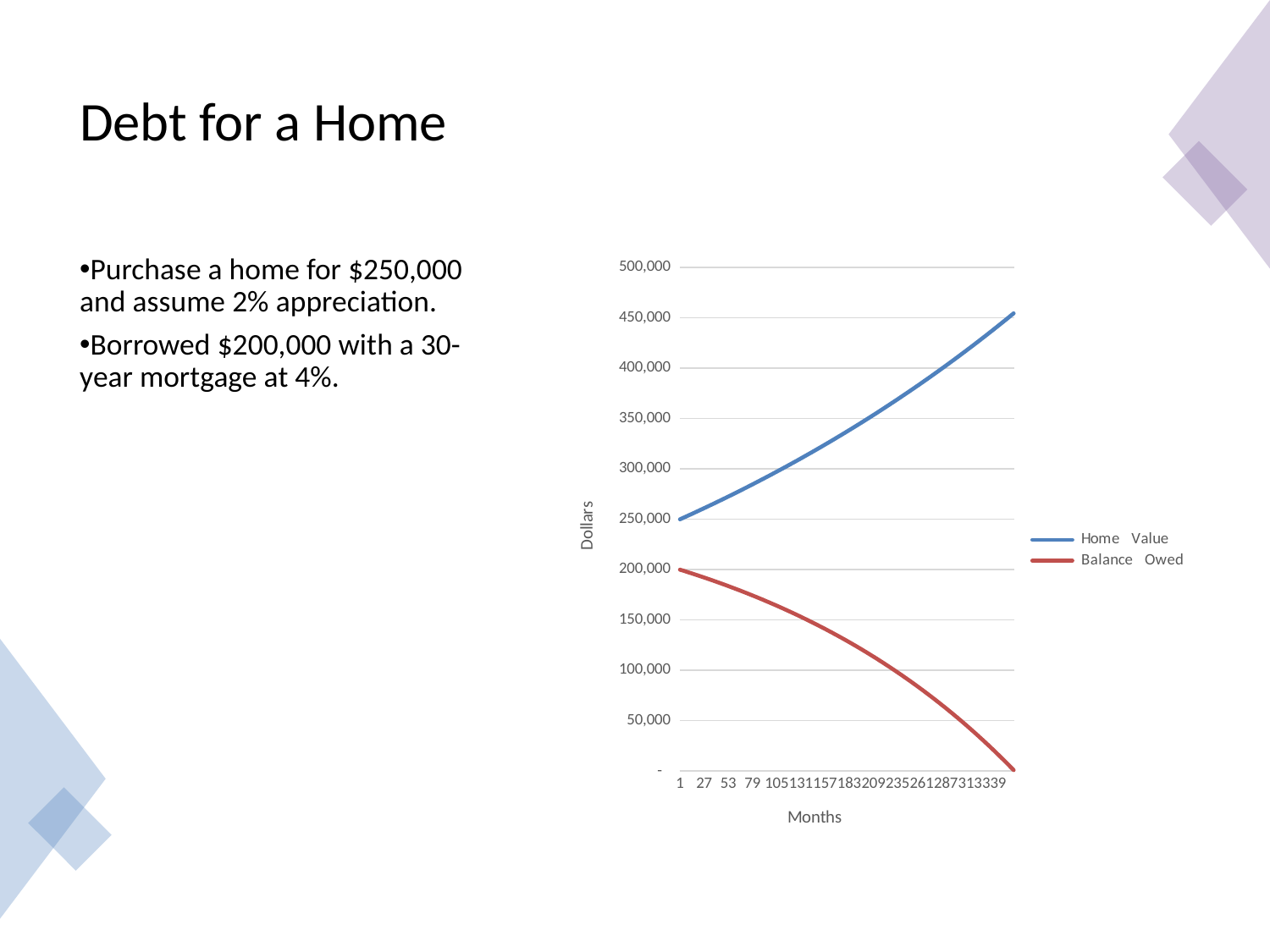
What kind of chart is shown on the slide? line chart What are the two series named in the chart's legend? Home Value and Balance Owed Is the Home Value at month 339 greater or less than 400,000? greater What is the Balance Owed at month 1? 200,000 Does the Balance Owed line rise or fall as the months increase? fall How many series does the chart's legend list? 2 Does the Home Value line rise or fall as the months increase? rise Is the Balance Owed at month 183 greater or less than 150,000? less What is the Home Value at month 1? 250,000 Is the Balance Owed at month 339 greater or less than 50,000? less What is the label on the chart's vertical axis? Dollars At month 1, which is larger: Home Value or Balance Owed? Home Value